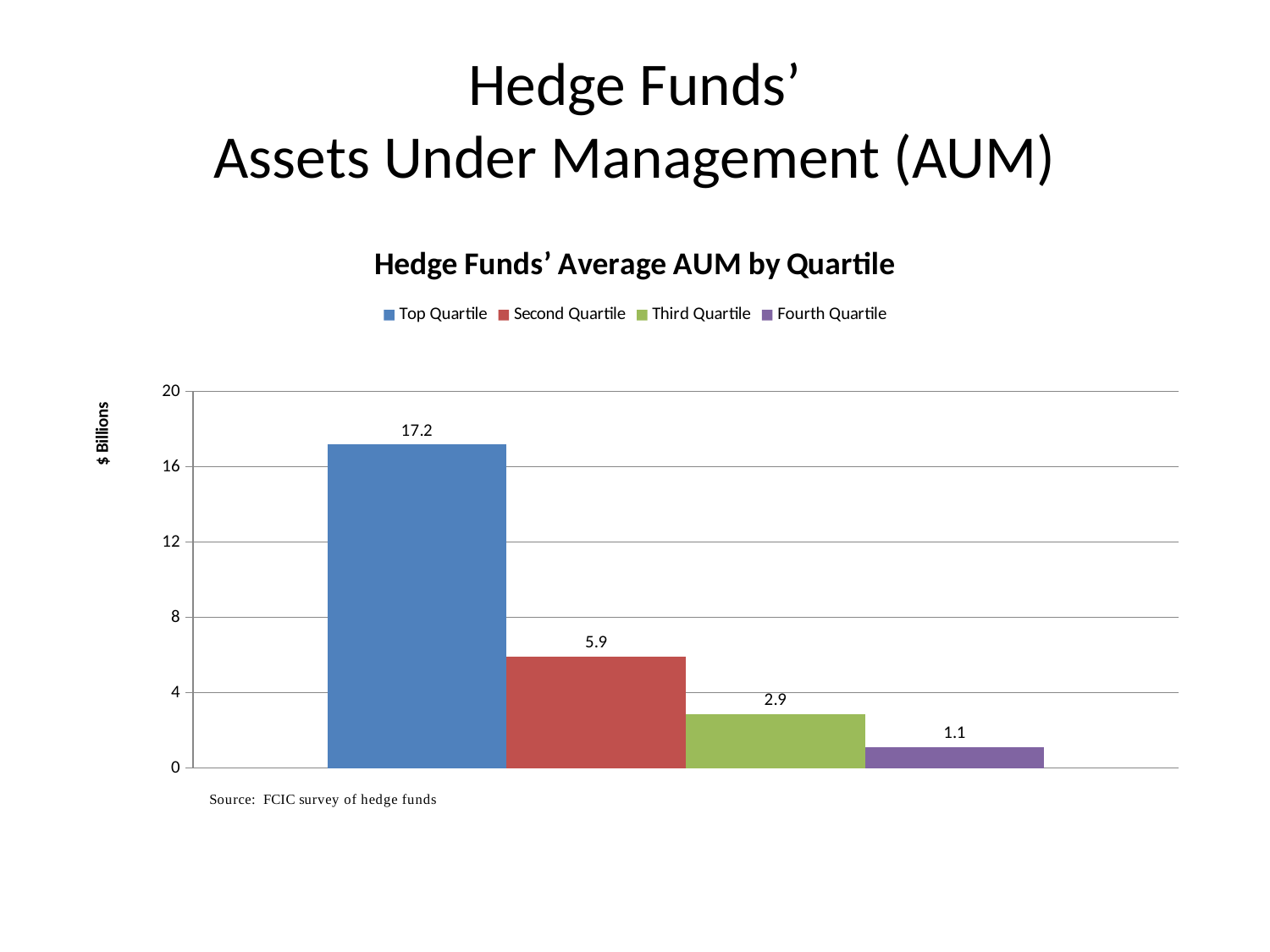
What is the average AUM for the Second Quartile? 5.9 Which quartile has the highest average AUM? Top Quartile What is the average AUM for the Fourth Quartile? 1.1 What is the title of the chart? Hedge Funds' Average AUM by Quartile Which has a larger average AUM, the Third Quartile or the Fourth Quartile? Third Quartile Is the value for the Second Quartile greater or less than 8? less How many series does the legend list? 4 What is the average AUM for the Top Quartile? 17.2 Which quartile has the lowest average AUM? Fourth Quartile What kind of chart is shown on the slide? Bar chart What is the average AUM for the Third Quartile? 2.9 What is the difference in average AUM between the Top Quartile and the Second Quartile? 11.3